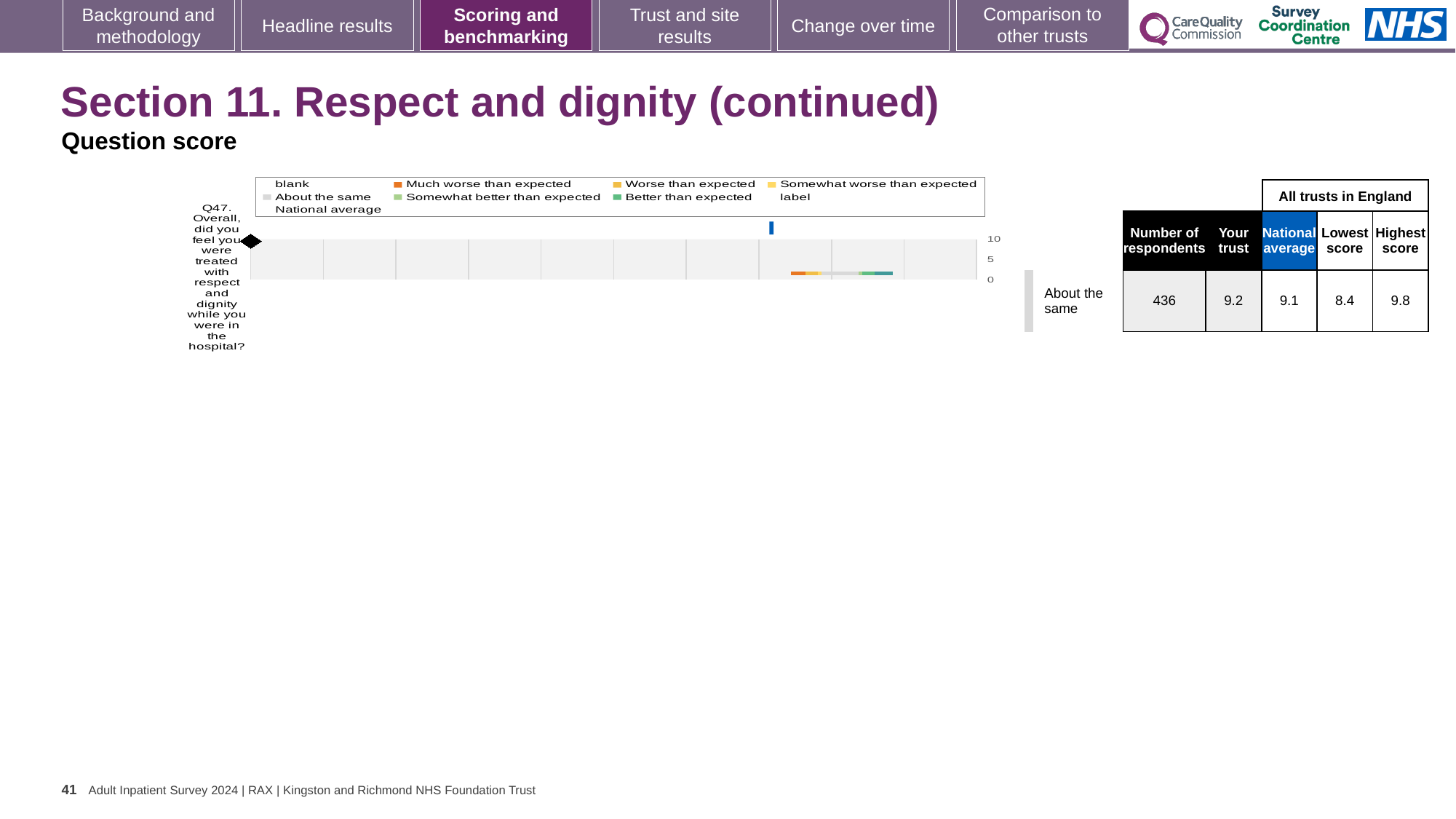
What is the highest value shown on the chart's axis? 10 In the table beside the chart, what is the difference between the highest score and the lowest score across all trusts in England for Q47? 1.4 In the table beside the chart, what is the 'Your trust' score for Q47? 9.2 Which question is plotted on the chart? Q47. Overall, did you feel you were treated with respect and dignity while you were in the hospital? In the table beside the chart, is the 'Your trust' score for Q47 higher or lower than the national average? higher In the table beside the chart, what is the national average score for Q47? 9.1 Is the national average marker for Q47 greater or less than 5 on the chart's axis? greater Which benchmarking category is Q47 assigned to, as labelled next to the chart? About the same How many questions are plotted on the chart? 1 In the table beside the chart, what is the number of respondents for Q47? 436 What kind of chart is shown on the slide? bar chart